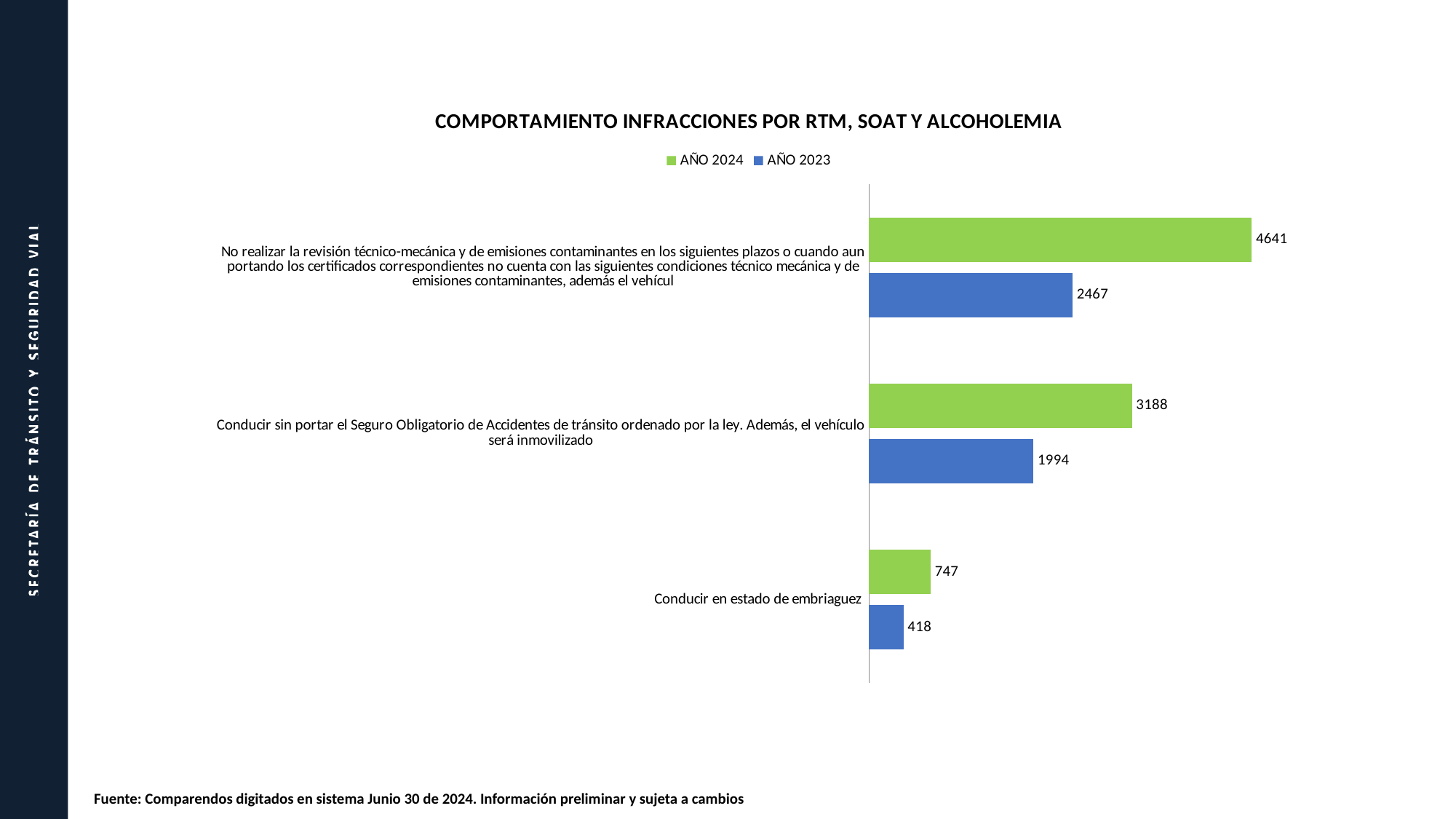
How many categories are shown in the chart? 3 What is the AÑO 2023 value for 'Conducir sin portar el Seguro Obligatorio de Accidentes de tránsito ordenado por la ley'? 1994 What is the AÑO 2023 value for the category about not performing the técnico-mecánica revision ('No realizar la revisión técnico-mecánica...')? 2467 Which category has the highest AÑO 2024 value? No realizar la revisión técnico-mecánica y de emisiones contaminantes... How many series does the legend list? 2 What kind of chart is shown on the slide? Bar chart What is the difference between the AÑO 2024 and AÑO 2023 values for 'Conducir en estado de embriaguez'? 329 Which is larger for 'Conducir sin portar el Seguro Obligatorio...': the AÑO 2024 value or the AÑO 2023 value? AÑO 2024 What is the title of the chart? COMPORTAMIENTO INFRACCIONES POR RTM, SOAT Y ALCOHOLEMIA Which category has the lowest AÑO 2023 value? Conducir en estado de embriaguez What is the difference between the AÑO 2024 and AÑO 2023 values for the 'No realizar la revisión técnico-mecánica...' category? 2174 What is the AÑO 2024 value for 'Conducir en estado de embriaguez'? 747